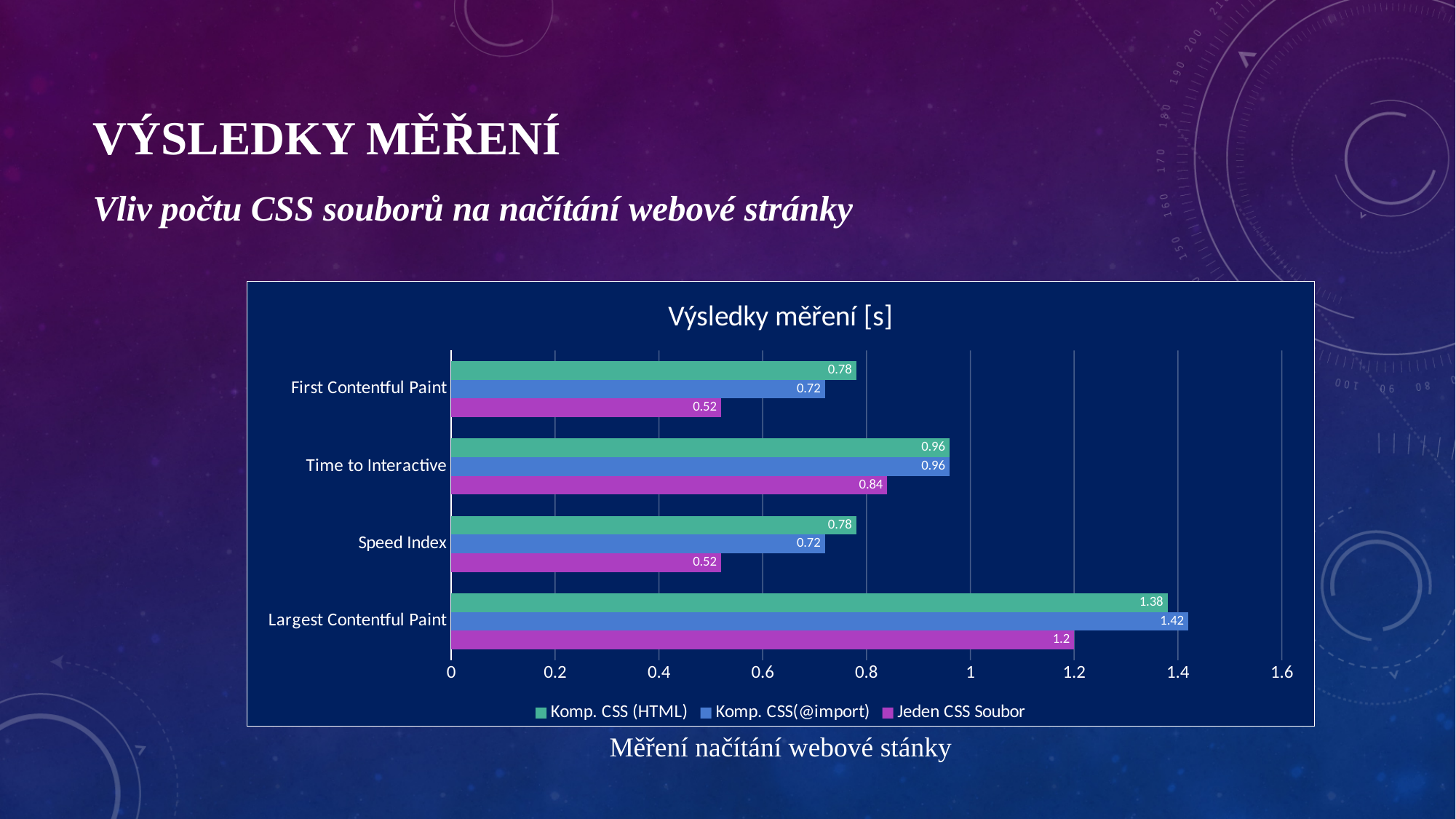
For Largest Contentful Paint, which is larger: Komp. CSS (HTML) or Komp. CSS(@import)? Komp. CSS(@import) What is the value for Komp. CSS (HTML) for Largest Contentful Paint? 1.38 What kind of chart is shown on the slide? bar chart How many series does the legend list? 3 What is the value for Komp. CSS(@import) for Speed Index? 0.72 Which category has the highest value for Jeden CSS Soubor? Largest Contentful Paint What is the title of the chart? Výsledky měření [s] What is the value for Jeden CSS Soubor for Time to Interactive? 0.84 What is the difference between Komp. CSS (HTML) and Jeden CSS Soubor for First Contentful Paint? 0.26 Is the value for Komp. CSS(@import) for Largest Contentful Paint greater or less than 1.2? greater How many categories are shown on the chart? 4